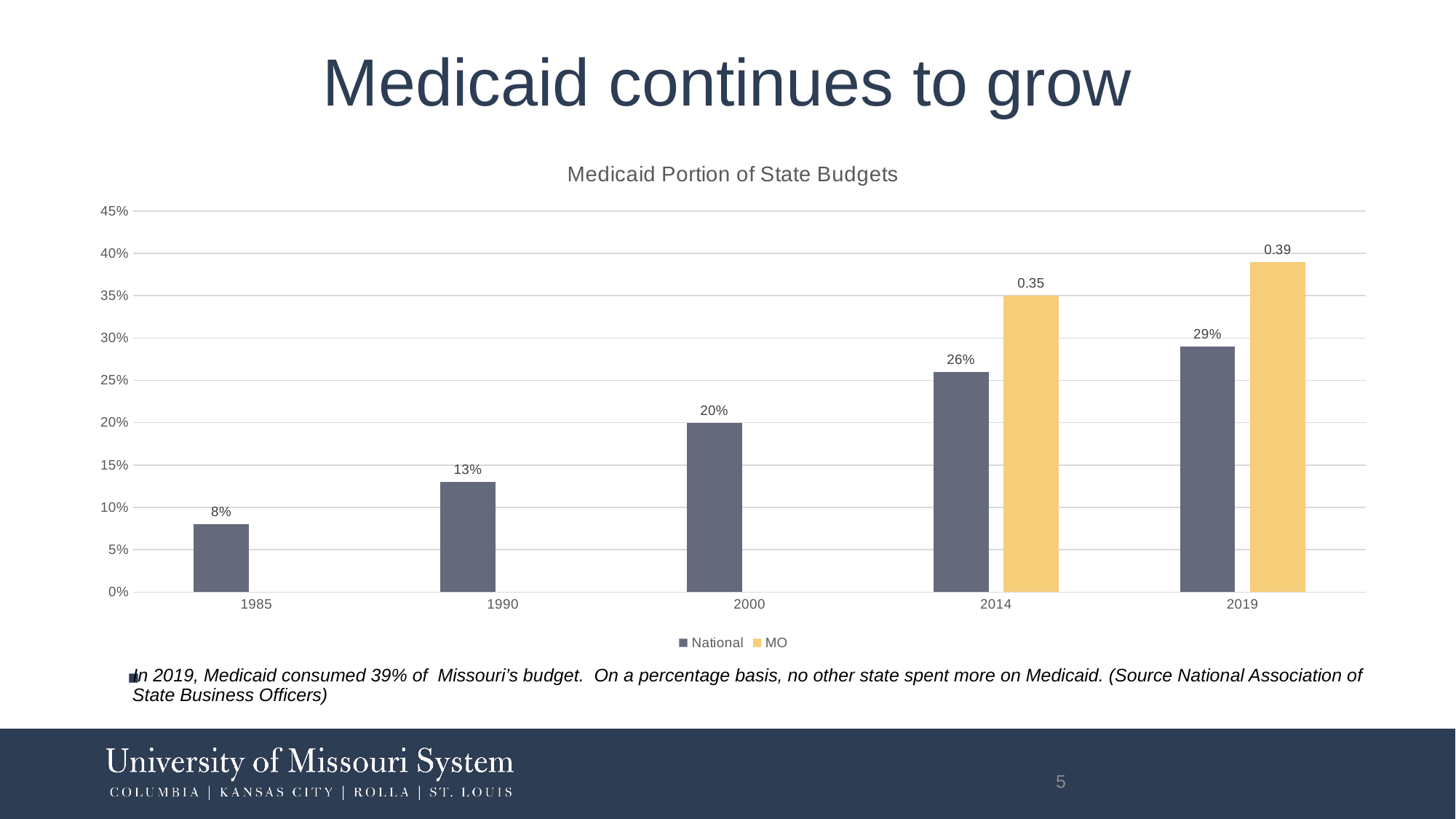
In 2014, which series has the larger value, National or MO? MO Which year has the highest National value? 2019 How many series does the legend list? 2 What is the difference between the National values for 2019 and 2014? 3% Which year has the lowest National value? 1985 What is the National value for 1985? 8% Do the National values rise or fall from 1985 to 2019? rise What is the National value for 2000 in the Medicaid Portion of State Budgets chart? 20% What is the MO value for 2019 as labelled on the chart? 0.39 How many years are shown on the x axis? 5 What is the MO value for 2014 as labelled on the chart? 0.35 Is the National value for 1990 greater or less than 15%? less